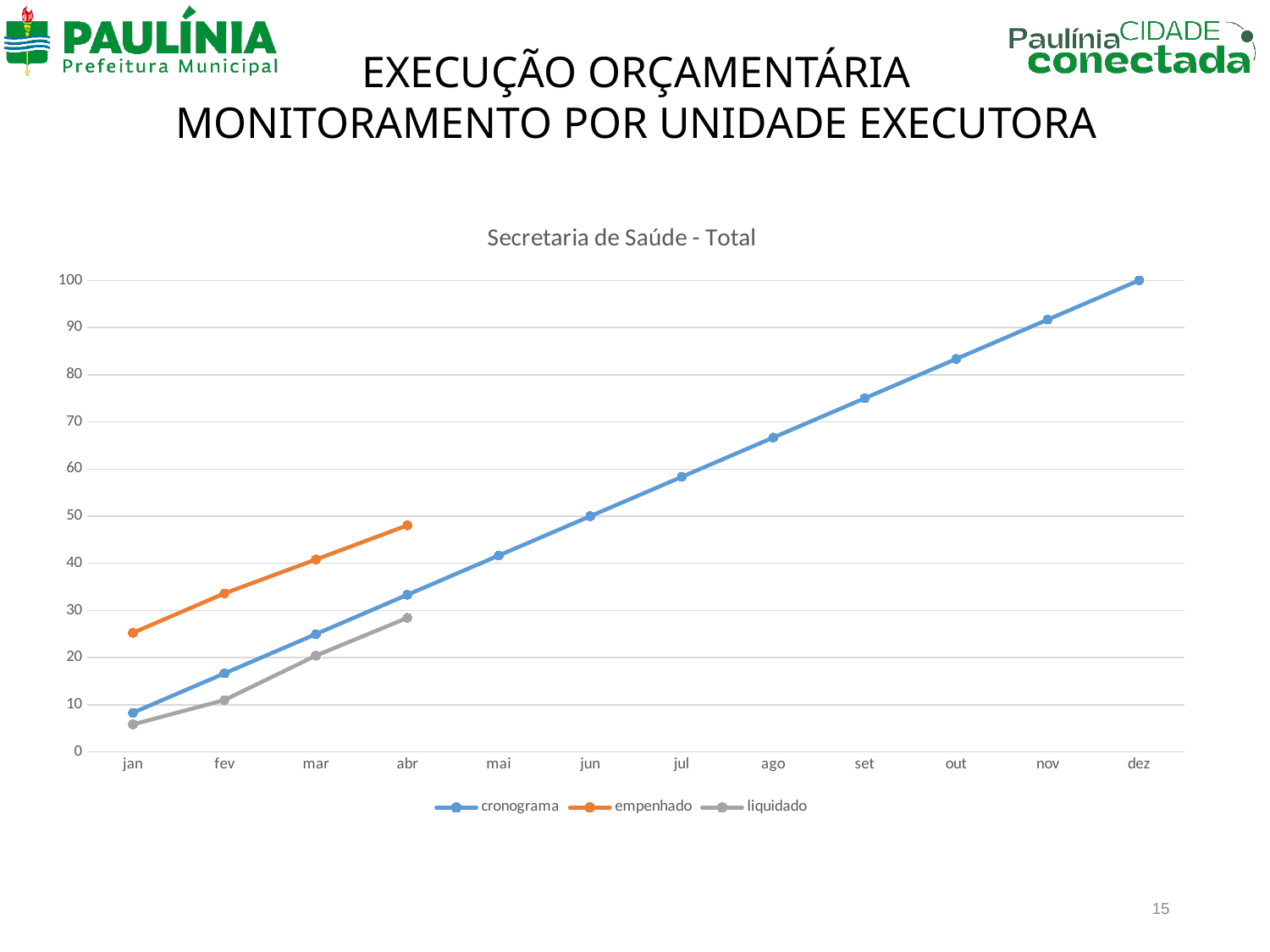
What kind of chart is shown on the slide? line chart What is the value of the cronograma series in jun? 50 Is the value of liquidado in jan greater or less than 10? less What is the value of the cronograma series in dez? 100 What is the title of the chart? Secretaria de Saúde - Total How many months are shown on the x axis? 12 In abr, which series has the higher value, empenhado or cronograma? empenhado Which series are listed in the legend? cronograma, empenhado, liquidado In which month does the cronograma series reach its highest value? dez Is the value of empenhado in abr greater or less than 40? greater Does the cronograma series rise or fall from jan to dez? rise How many series does the legend list? 3